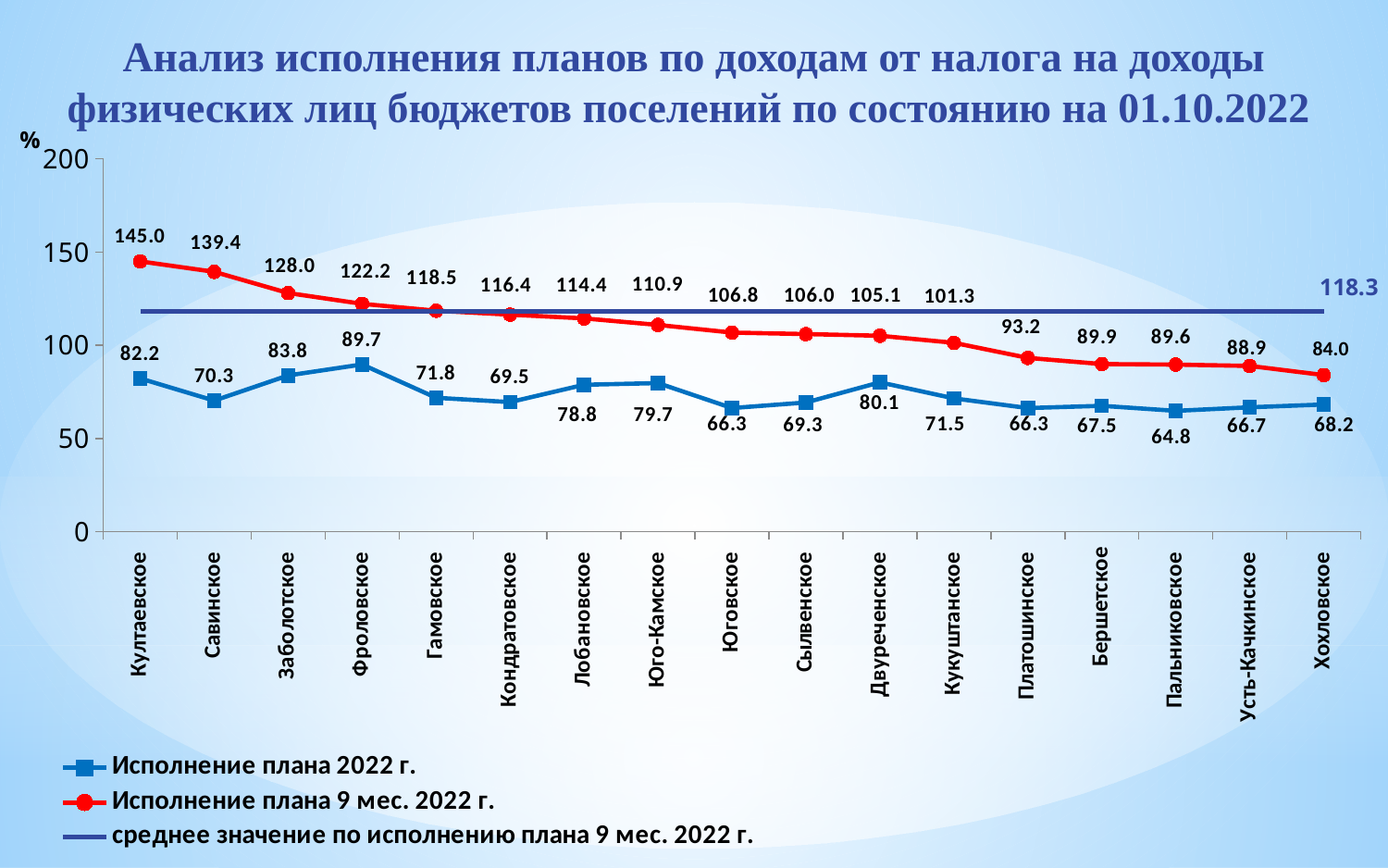
Which is larger for Двуреченское: 'Исполнение плана 2022 г.' or 'Исполнение плана 9 мес. 2022 г.'? Исполнение плана 9 мес. 2022 г. What is the difference between the 'Исполнение плана 9 мес. 2022 г.' values for Култаевское and Савинское? 5.6 How many series does the legend list? 3 What type of chart is shown on the slide? line chart What is the value of 'Исполнение плана 9 мес. 2022 г.' for Култаевское? 145.0 What colour is the line for 'Исполнение плана 9 мес. 2022 г.'? red What is the value of 'Исполнение плана 2022 г.' for Фроловское? 89.7 How many settlements are shown along the x axis? 17 Which settlement has the lowest value for 'Исполнение плана 9 мес. 2022 г.'? Хохловское What is the value of the average line 'среднее значение по исполнению плана 9 мес. 2022 г.'? 118.3 Does the 'Исполнение плана 9 мес. 2022 г.' series rise or fall from left to right along the x axis? fall Which settlement has the highest value for 'Исполнение плана 2022 г.'? Фроловское